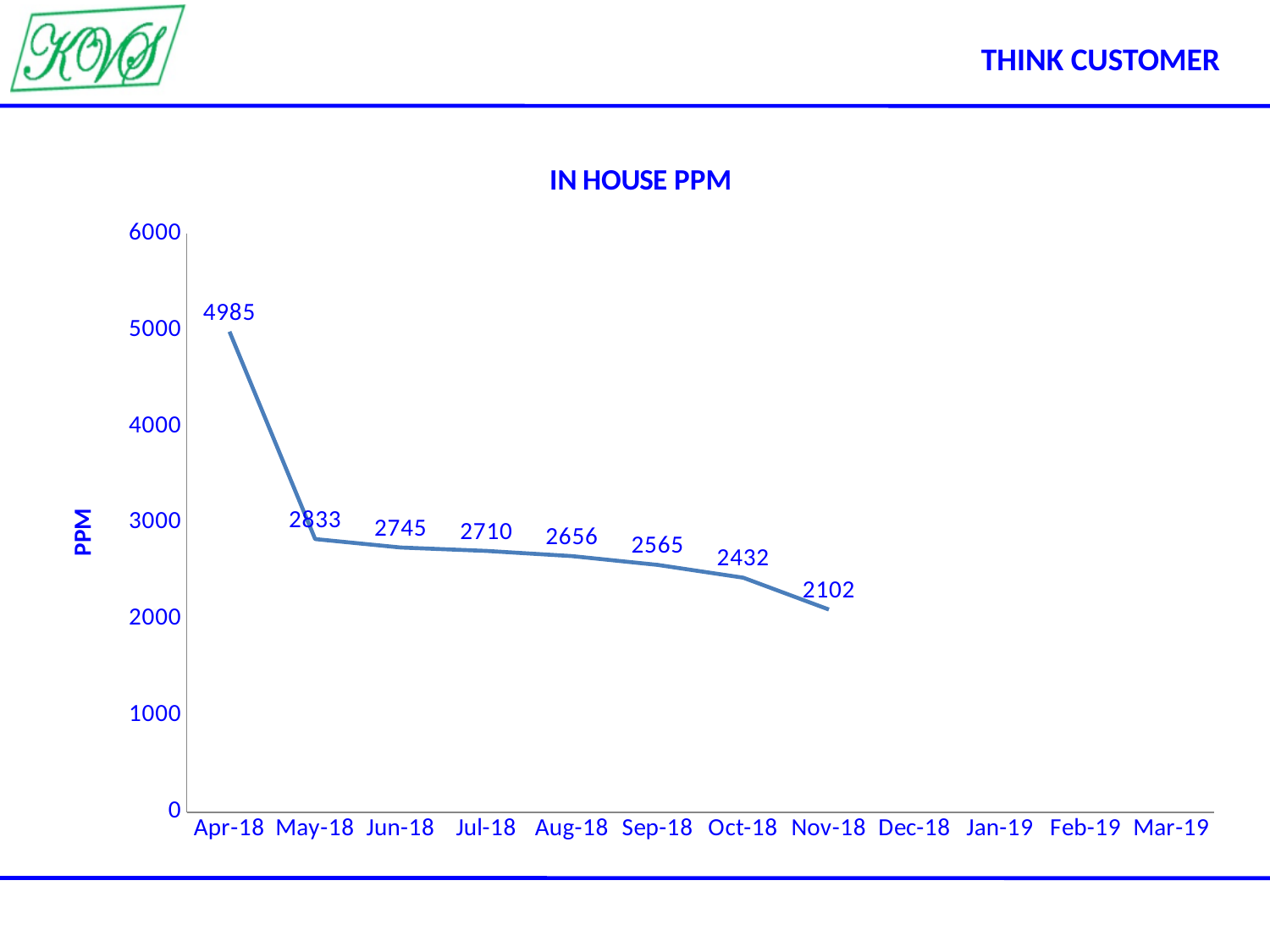
What kind of chart is shown on the slide? line chart What is the In House PPM value for Apr-18? 4985 Which is larger, the In House PPM value for Jun-18 or for Sep-18? Jun-18 What is the difference between the In House PPM values for Oct-18 and Nov-18? 330 Which month has the highest In House PPM value? Apr-18 What is the difference between the In House PPM values for Apr-18 and May-18? 2152 How many months have a plotted data point on the In House PPM chart? 8 Which month has the lowest plotted In House PPM value? Nov-18 What is the In House PPM value for Nov-18? 2102 Is the In House PPM value for Jul-18 greater or less than 3000? less Do the In House PPM values rise or fall from Apr-18 to Nov-18? fall What is the In House PPM value for Aug-18? 2656